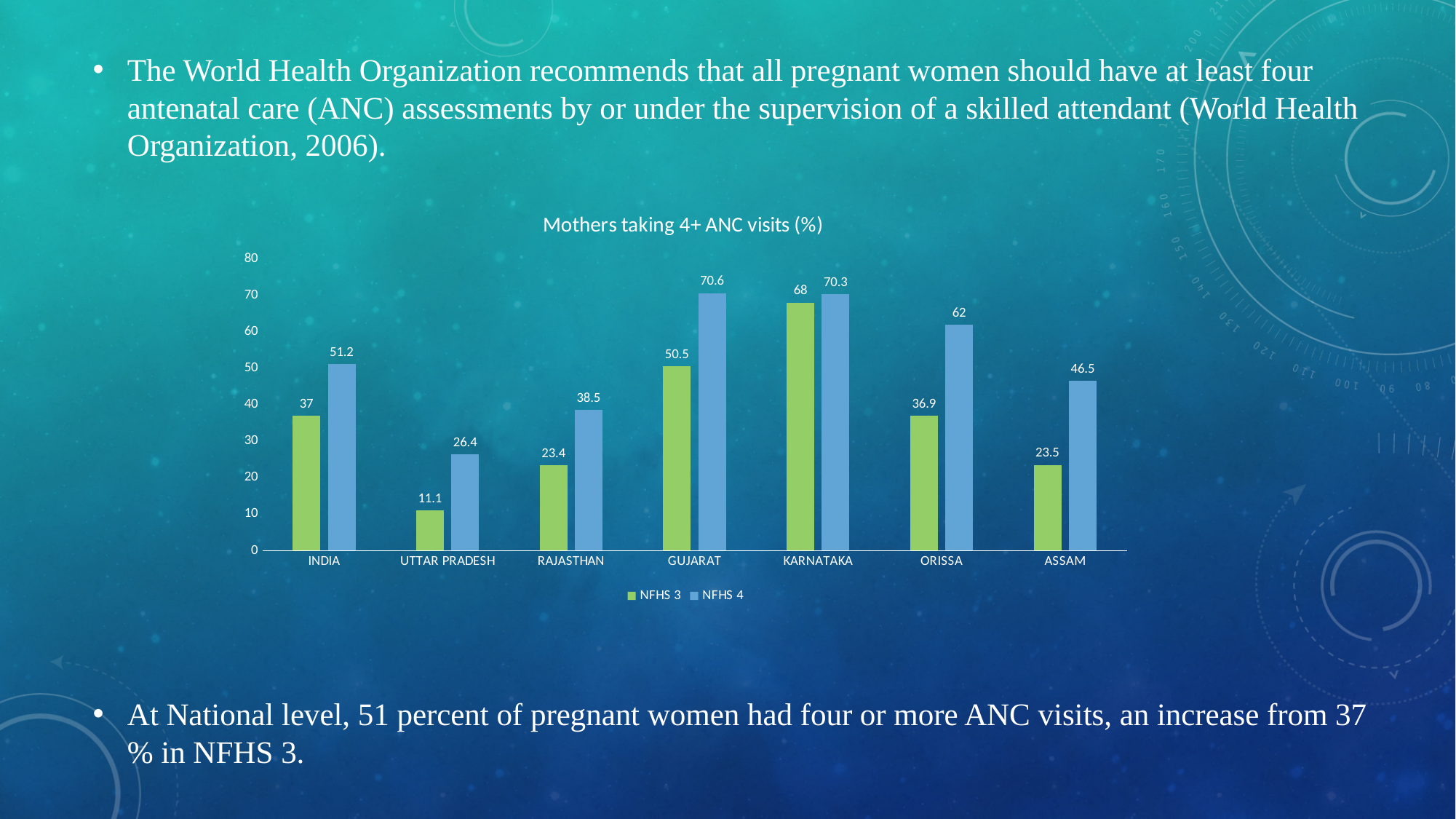
Which category has the lowest NFHS 3 value? Uttar Pradesh Which series is shown in green? NFHS 3 What is the NFHS 3 value for Uttar Pradesh? 11.1 What is the NFHS 4 value for India? 51.2 Which state has the highest NFHS 4 value? Gujarat Which is larger: the NFHS 3 value for Gujarat or the NFHS 3 value for Karnataka? Karnataka What is the title of the chart? Mothers taking 4+ ANC visits (%) How many series does the legend list? 2 What is the difference between the NFHS 4 and NFHS 3 values for Orissa? 25.1 What kind of chart is shown on the slide? Bar chart How many categories are shown on the x axis? 7 What is the NFHS 4 value for Orissa? 62